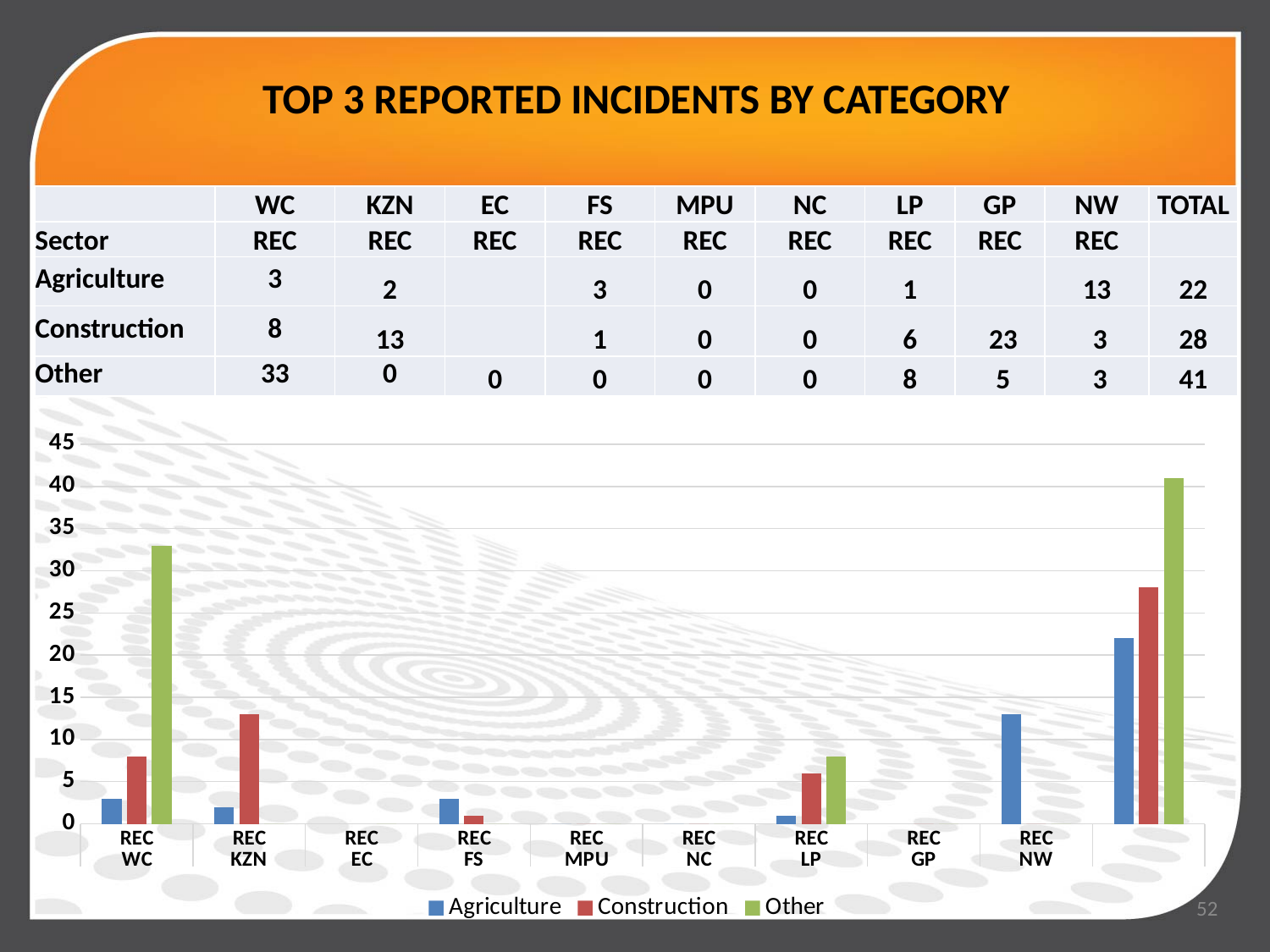
What type of chart is shown on the slide? bar chart For REC WC, which series has the tallest bar? Other Is the Other value for REC WC greater or less than 30? greater What is the Construction value for REC WC? 8 Which is larger: the Other value for REC WC or the Construction value for REC KZN? Other value for REC WC What is the difference between the Other value and the Construction value for REC WC? 25 For REC LP, which series has the lowest value? Agriculture What is the Construction value for REC KZN? 13 What are the series names listed in the chart legend? Agriculture, Construction, Other How many series does the chart legend list? 3 Is the Construction value for REC KZN greater or less than 10? greater What is the Other value for REC WC? 33